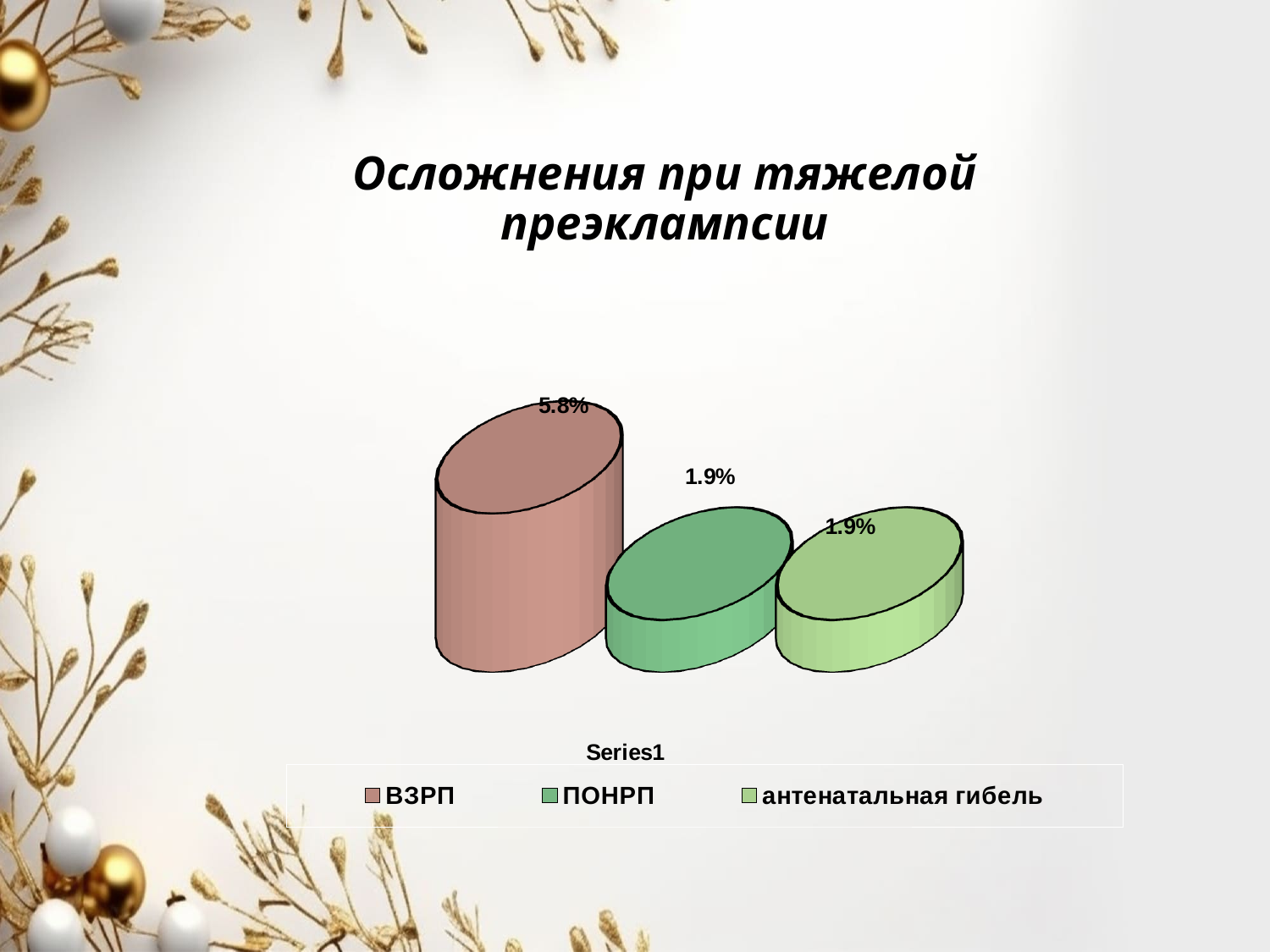
What is the difference between the values for ВЗРП and ПОНРП? 3.9% How many categories are shown in the chart? 3 How many entries does the legend list? 3 What is the value for антенатальная гибель? 1.9% What is the value for ВЗРП? 5.8% Do the values for ПОНРП and антенатальная гибель differ? No, both are 1.9% What is the title of the slide? Осложнения при тяжелой преэклампсии Which is larger, the value for ВЗРП or the value for антенатальная гибель? ВЗРП What kind of chart is shown on the slide? Bar chart Which category has the highest value? ВЗРП What is the value for ПОНРП? 1.9% What colour is the bar for ВЗРП? Pink (brownish-pink)